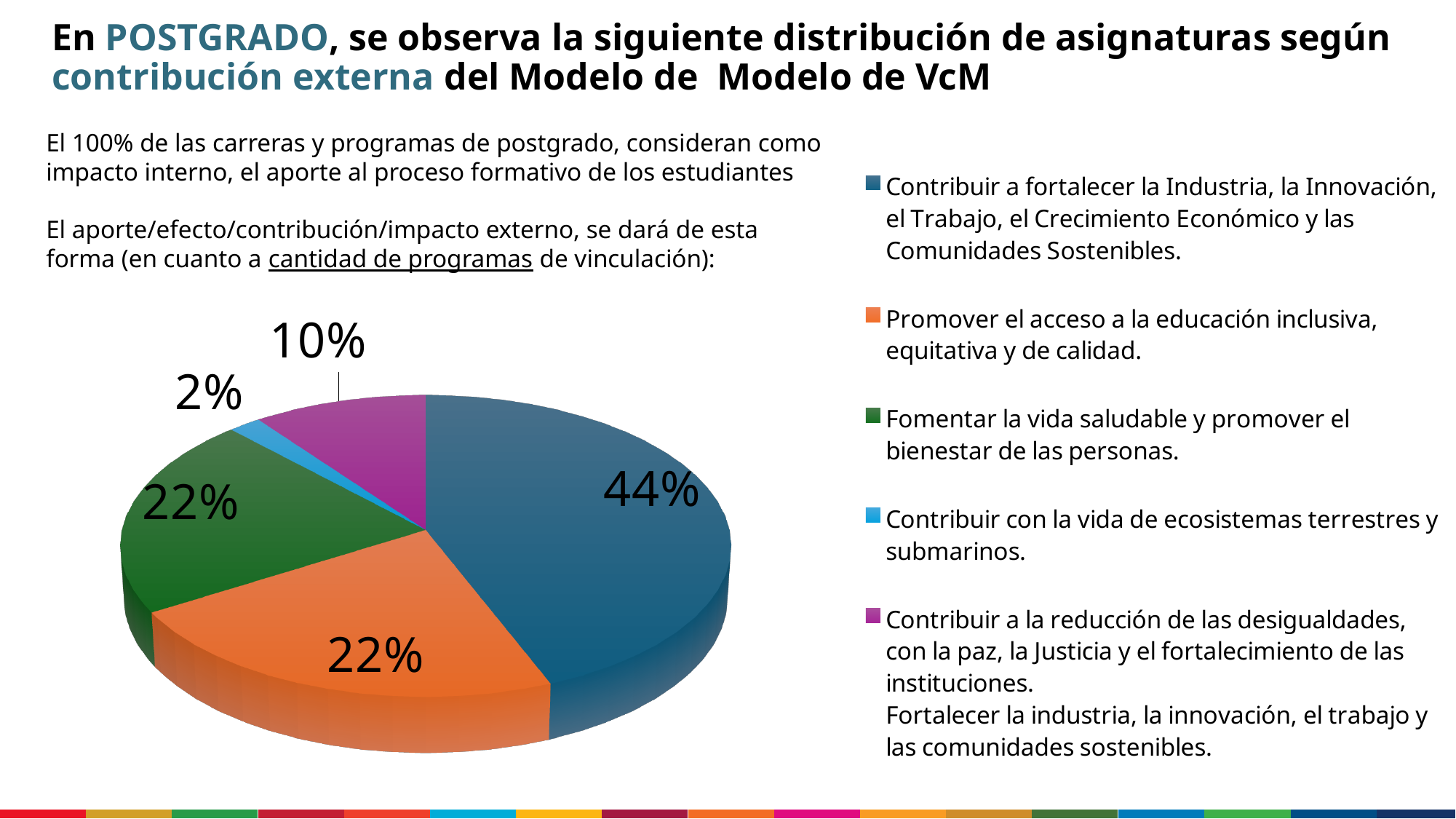
How many entries does the legend list? 5 What share of the pie corresponds to "Contribuir a fortalecer la Industria, la Innovación, el Trabajo, el Crecimiento Económico y las Comunidades Sostenibles"? 44% What is the difference in percentage points between the largest slice (44%) and the slice for "Contribuir a la reducción de las desigualdades" (10%)? 34 Which category has the smallest slice of the pie? Contribuir con la vida de ecosistemas terrestres y submarinos What share of the pie corresponds to "Contribuir con la vida de ecosistemas terrestres y submarinos"? 2% Which category has the largest slice of the pie? Contribuir a fortalecer la Industria, la Innovación, el Trabajo, el Crecimiento Económico y las Comunidades Sostenibles How many slices does the pie chart have? 5 What share of the pie corresponds to "Promover el acceso a la educación inclusiva, equitativa y de calidad"? 22% What kind of chart is shown on the slide? pie chart What colour is the slice for "Contribuir con la vida de ecosistemas terrestres y submarinos"? light blue